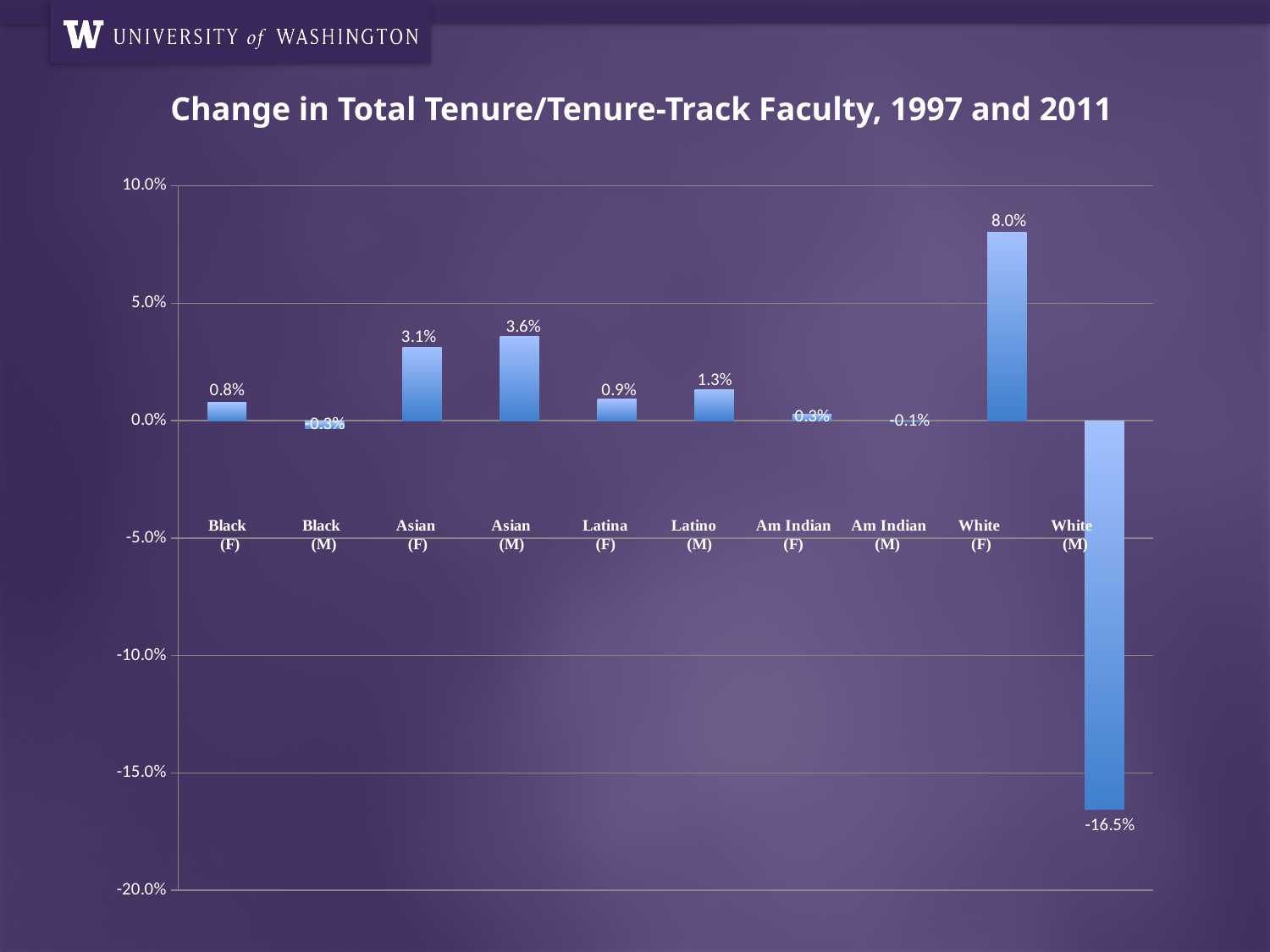
How many categories are shown on the x axis? 10 What is the value for White (F)? 8.0% Is the value for White (M) greater or less than -15.0%? less What is the value for Asian (M)? 3.6% Which is larger, the value for Latino (M) or the value for Latina (F)? Latino (M) What is the value for Latino (M)? 1.3% Which category has the lowest value? White (M) What is the title of the chart? Change in Total Tenure/Tenure-Track Faculty, 1997 and 2011 What is the value for White (M)? -16.5% What is the difference between the values for Asian (M) and Asian (F)? 0.5% Which category has the highest value? White (F) What kind of chart is shown on the slide? Bar chart